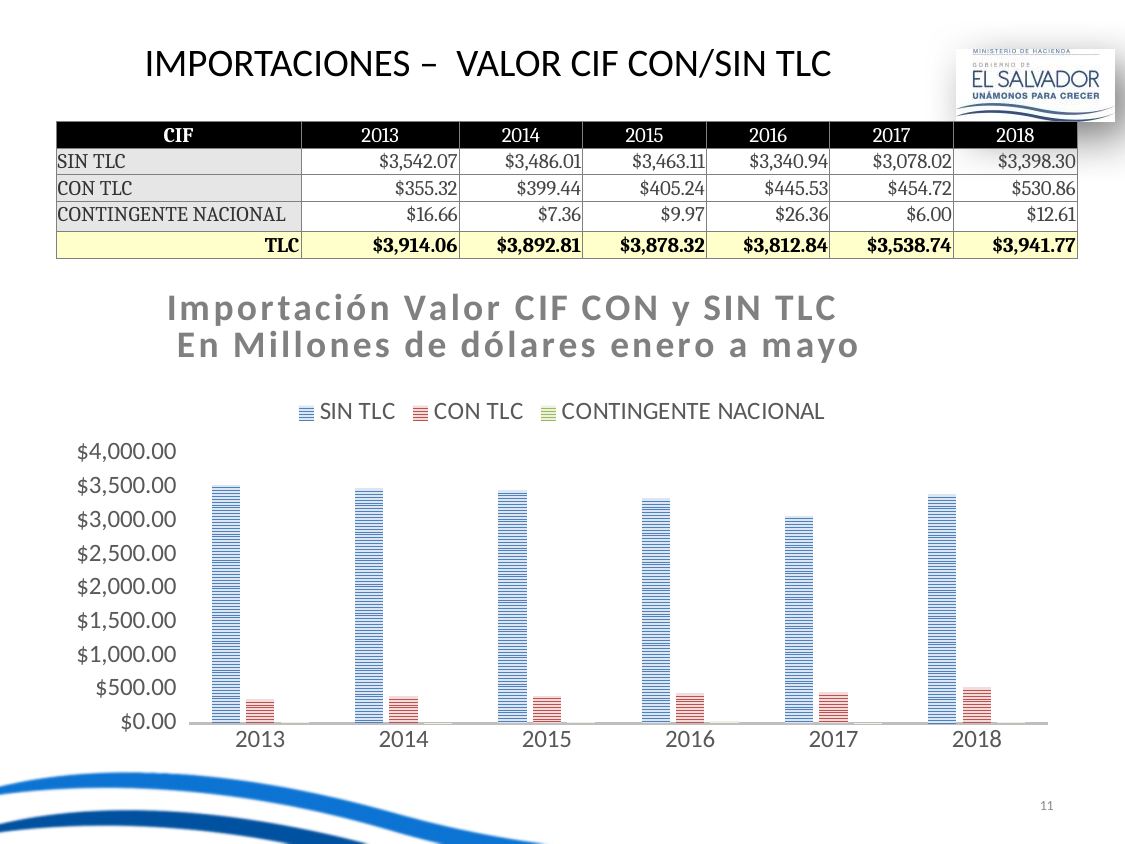
Is the SIN TLC value for 2016 greater or less than $3,500.00? less How many series does the chart legend list? 3 In which year is the SIN TLC value lowest? 2017 In which year is the CON TLC value highest? 2018 What is the difference between the SIN TLC values for 2013 and 2017? $464.05 What is the CON TLC value for 2018? $530.86 What is the SIN TLC value for 2013? $3,542.07 What is the CONTINGENTE NACIONAL value for 2016? $26.36 Which is larger, the SIN TLC value for 2018 or the SIN TLC value for 2017? 2018 How many years are shown along the x axis of the chart? 6 Do the CON TLC values rise or fall from 2013 to 2018? rise What kind of chart is shown on the slide? bar chart